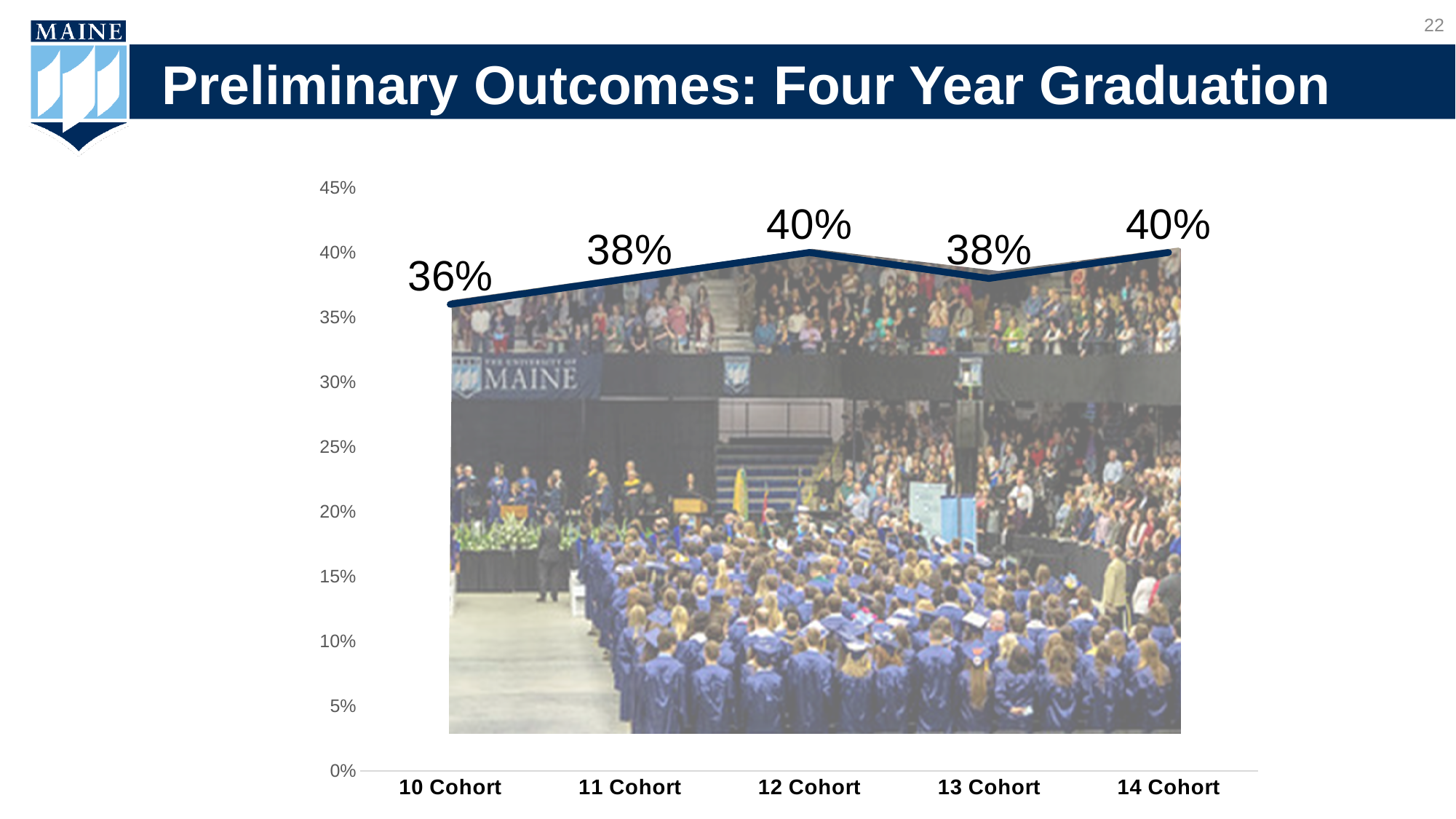
Does the graduation rate rise or fall from the 10 Cohort to the 11 Cohort? Rise What is the title of the slide containing the chart? Preliminary Outcomes: Four Year Graduation What kind of chart is shown on the slide? Line chart What is the difference between the graduation rates of the 11 Cohort and the 10 Cohort? 2% How many cohorts are plotted on the chart? 5 Is the value for the 13 Cohort greater or less than 35%? greater What is the four year graduation rate for the 12 Cohort? 40% What is the four year graduation rate for the 13 Cohort? 38% What is the four year graduation rate for the 10 Cohort? 36% What is the difference between the graduation rates of the 12 Cohort and the 10 Cohort? 4% Which has a higher graduation rate, the 11 Cohort or the 14 Cohort? 14 Cohort Which cohort has the lowest four year graduation rate? 10 Cohort